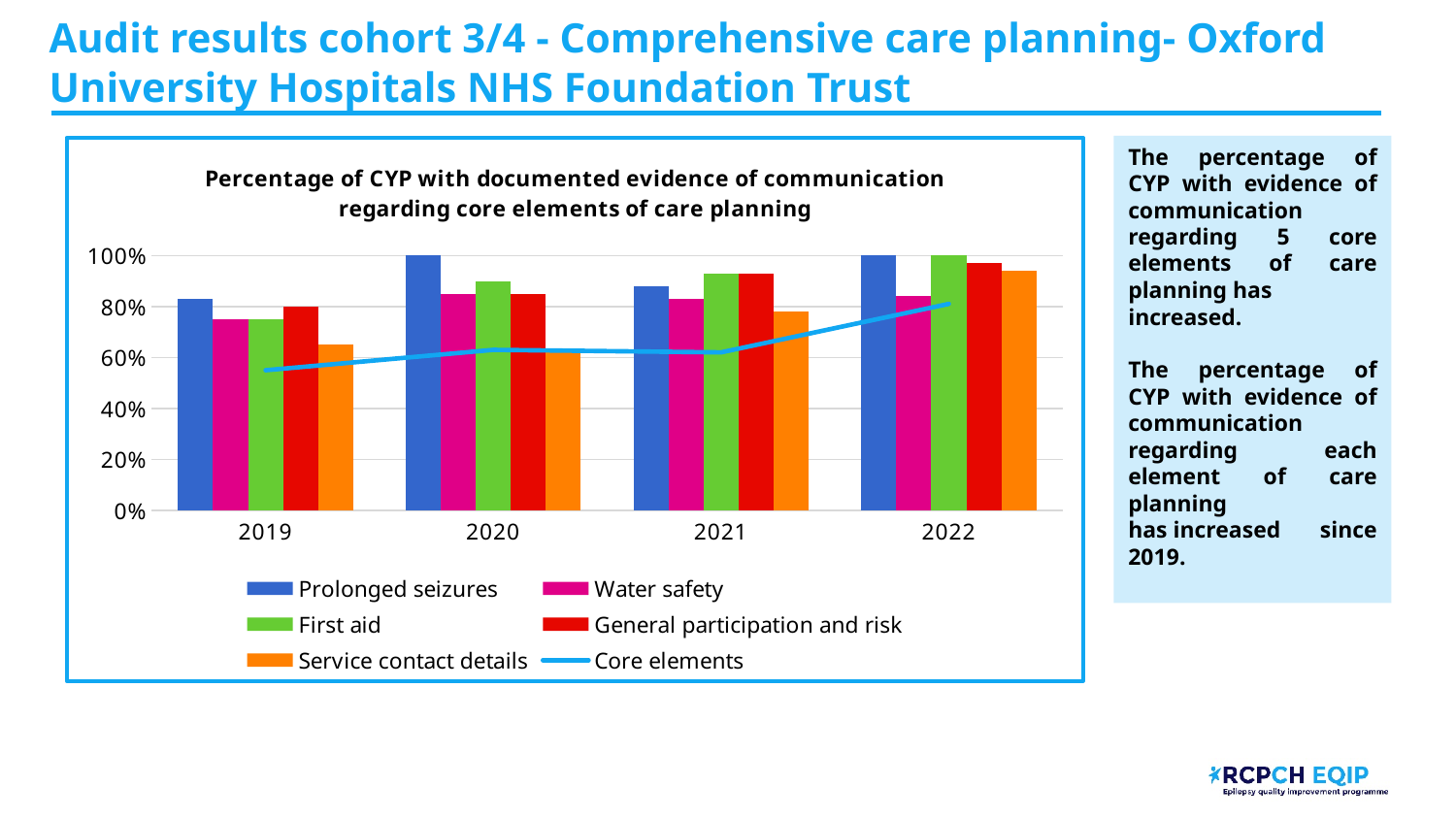
How many years are shown on the x axis? 4 In 2022, which is larger: Prolonged seizures or Water safety? Prolonged seizures Is the value for General participation and risk in 2022 greater or less than 80%? greater Which series has the highest value in 2020? Prolonged seizures Does the Core elements line rise or fall from 2019 to 2022? Rises What is the value for Prolonged seizures in 2020? 100% How many series does the legend list? 6 What is the value for First aid in 2022? 100% Which series has the lowest value in 2019? Core elements What kind of chart is shown on the slide? Bar chart with a line Is the value for Service contact details in 2019 greater or less than 80%? less